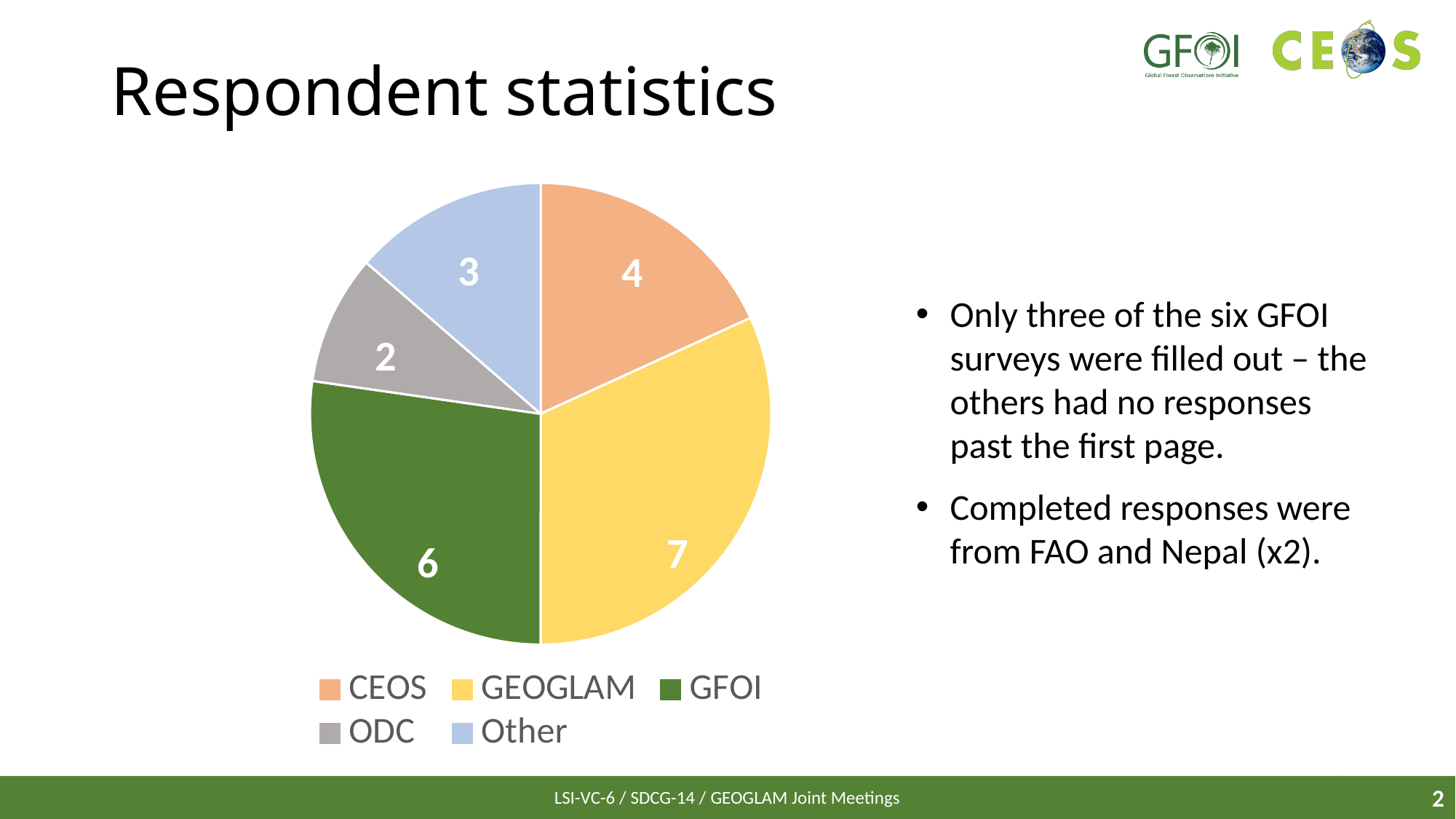
What is the difference between the GEOGLAM and CEOS values? 3 What is the value of the ODC slice? 2 What colour is the GFOI slice in the pie chart? green What is the total of all the slices in the pie chart? 22 What kind of chart is shown on the slide? pie chart Which category has the largest slice of the pie? GEOGLAM What is the value of the GFOI slice? 6 Which is larger, the GFOI slice or the Other slice? GFOI Which category has the smallest slice of the pie? ODC How many respondents are shown for GEOGLAM? 7 What is the value of the CEOS slice? 4 How many categories does the pie chart have? 5